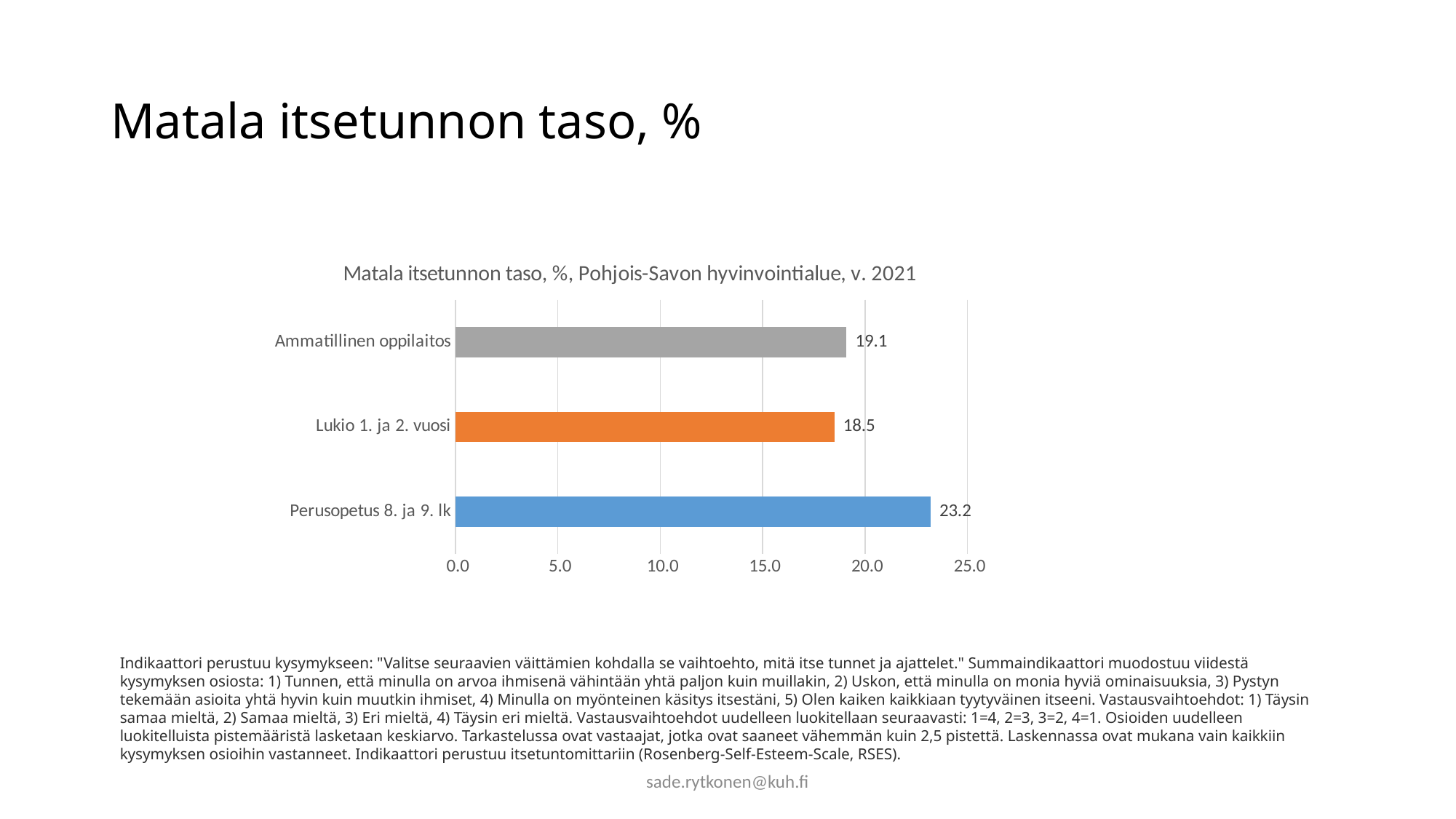
What kind of chart is shown on the slide? bar chart Is the value for Perusopetus 8. ja 9. lk greater or less than 20.0? greater Which category has the lowest value? Lukio 1. ja 2. vuosi What is the value for Ammatillinen oppilaitos? 19.1 What is the difference between the values for Perusopetus 8. ja 9. lk and Lukio 1. ja 2. vuosi? 4.7 Which category has the highest value? Perusopetus 8. ja 9. lk What is the value for Lukio 1. ja 2. vuosi? 18.5 Which is larger, the value for Perusopetus 8. ja 9. lk or the value for Ammatillinen oppilaitos? Perusopetus 8. ja 9. lk What is the difference between the values for Ammatillinen oppilaitos and Lukio 1. ja 2. vuosi? 0.6 What is the value for Perusopetus 8. ja 9. lk? 23.2 What is the title of the chart? Matala itsetunnon taso, %, Pohjois-Savon hyvinvointialue, v. 2021 How many categories are shown in the chart? 3